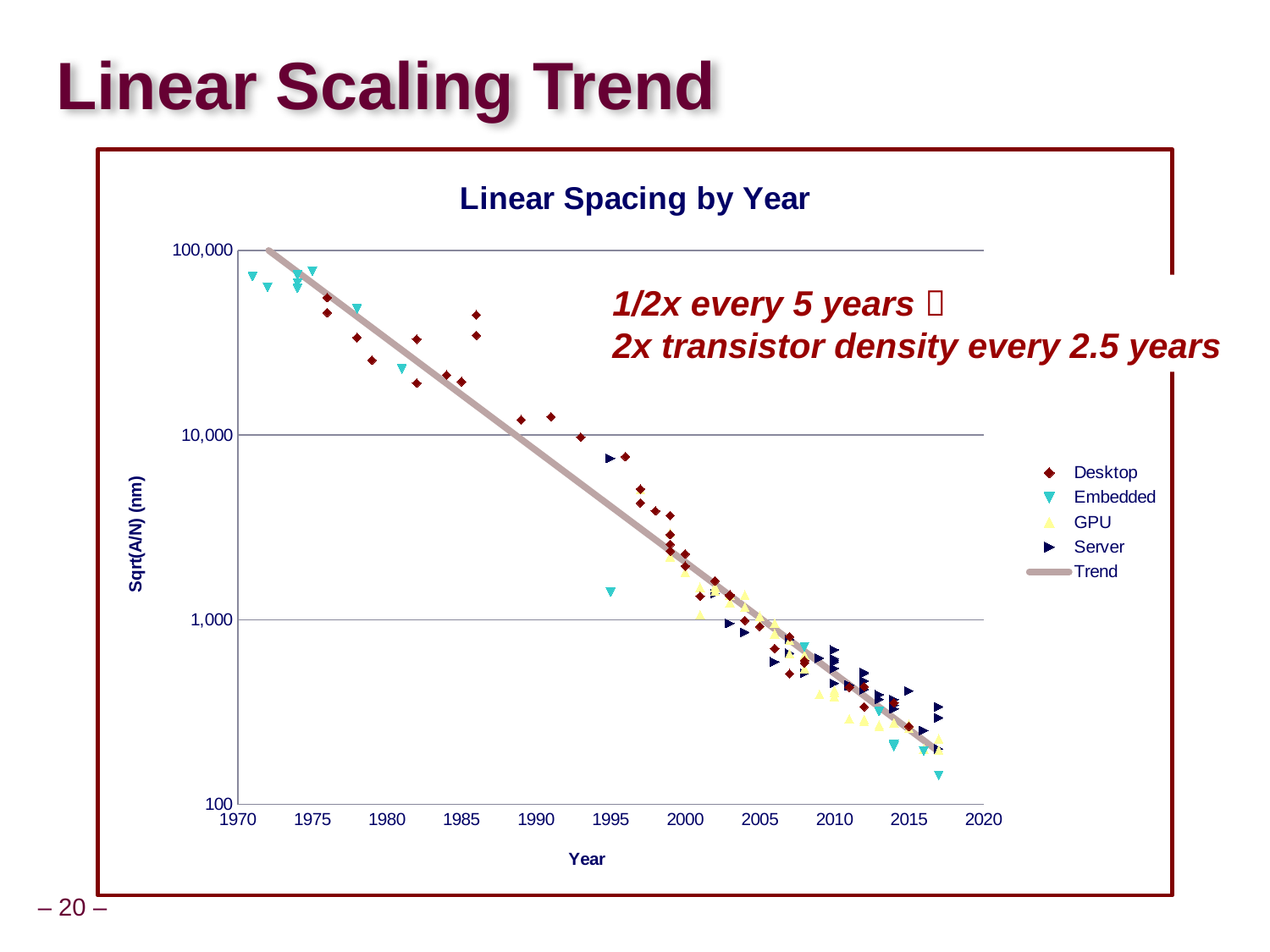
Are the GPU values around 2015 greater or less than 1,000? less Do the plotted values generally rise or fall as the year increases along the x axis? fall What is the title of the chart? Linear Spacing by Year How many entries does the legend of the chart list? 5 What is the label of the y axis of the chart? Sqrt(A/N) (nm) What kind of chart is shown on the slide? scatter chart Are the Embedded values around 2017 greater or less than 1,000? less Are the Embedded values around 1971 greater or less than 10,000? greater